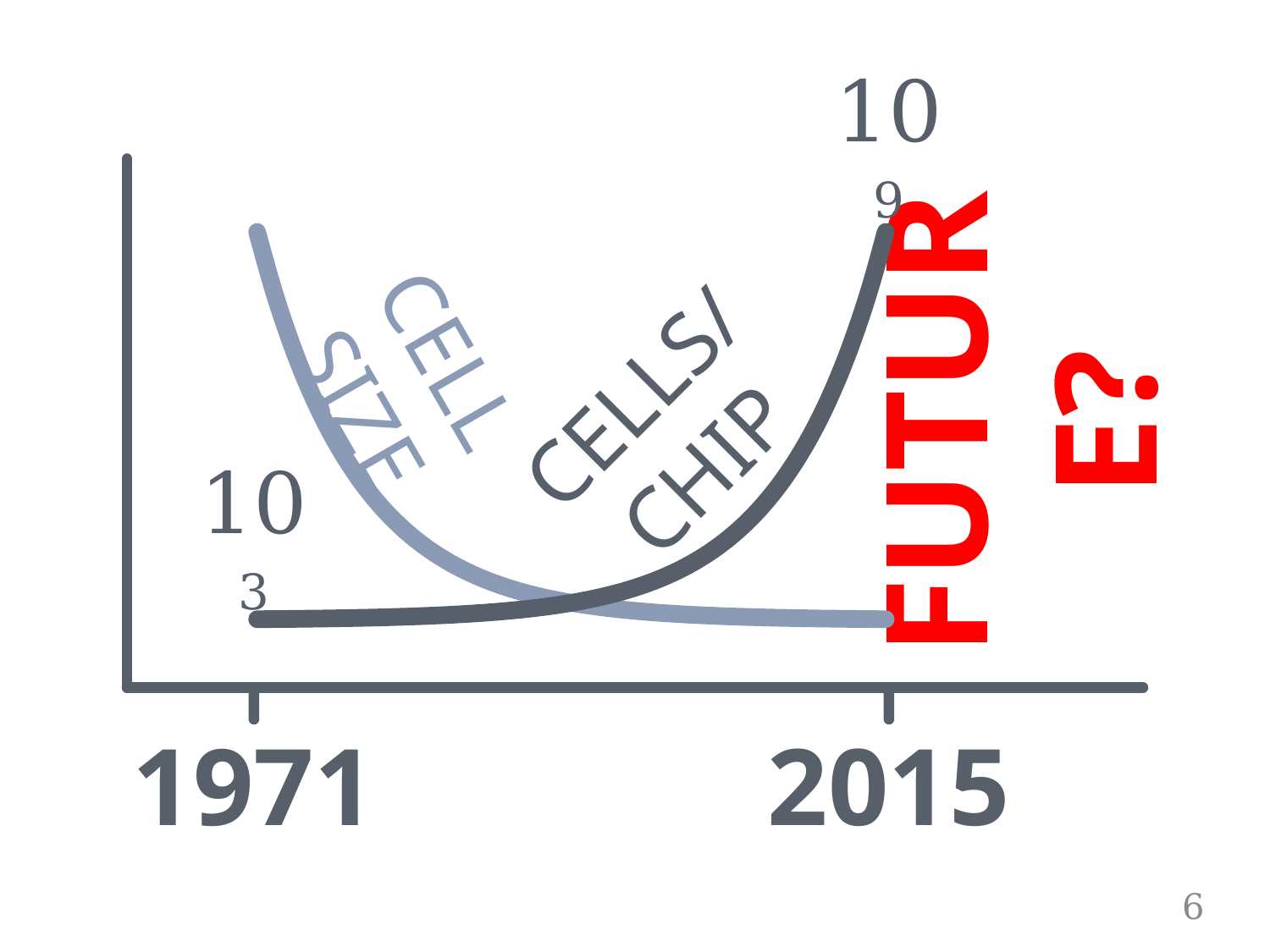
How many years are marked as ticks on the x axis? 2 Does the CELL SIZE curve rise or fall from 1971 to 2015? fall What value is labelled for CELLS/CHIP at 2015? 10⁹ At 1971, which curve is higher, CELL SIZE or CELLS/CHIP? CELL SIZE What are the two curves on the chart labelled? CELL SIZE and CELLS/CHIP Does the CELLS/CHIP curve rise or fall from 1971 to 2015? rise What kind of chart is shown on the slide? line chart Which two years are labelled on the x axis? 1971 and 2015 At 2015, which curve is higher, CELL SIZE or CELLS/CHIP? CELLS/CHIP How many curves are plotted on the chart? 2 What value is labelled for CELLS/CHIP at 1971? 10³